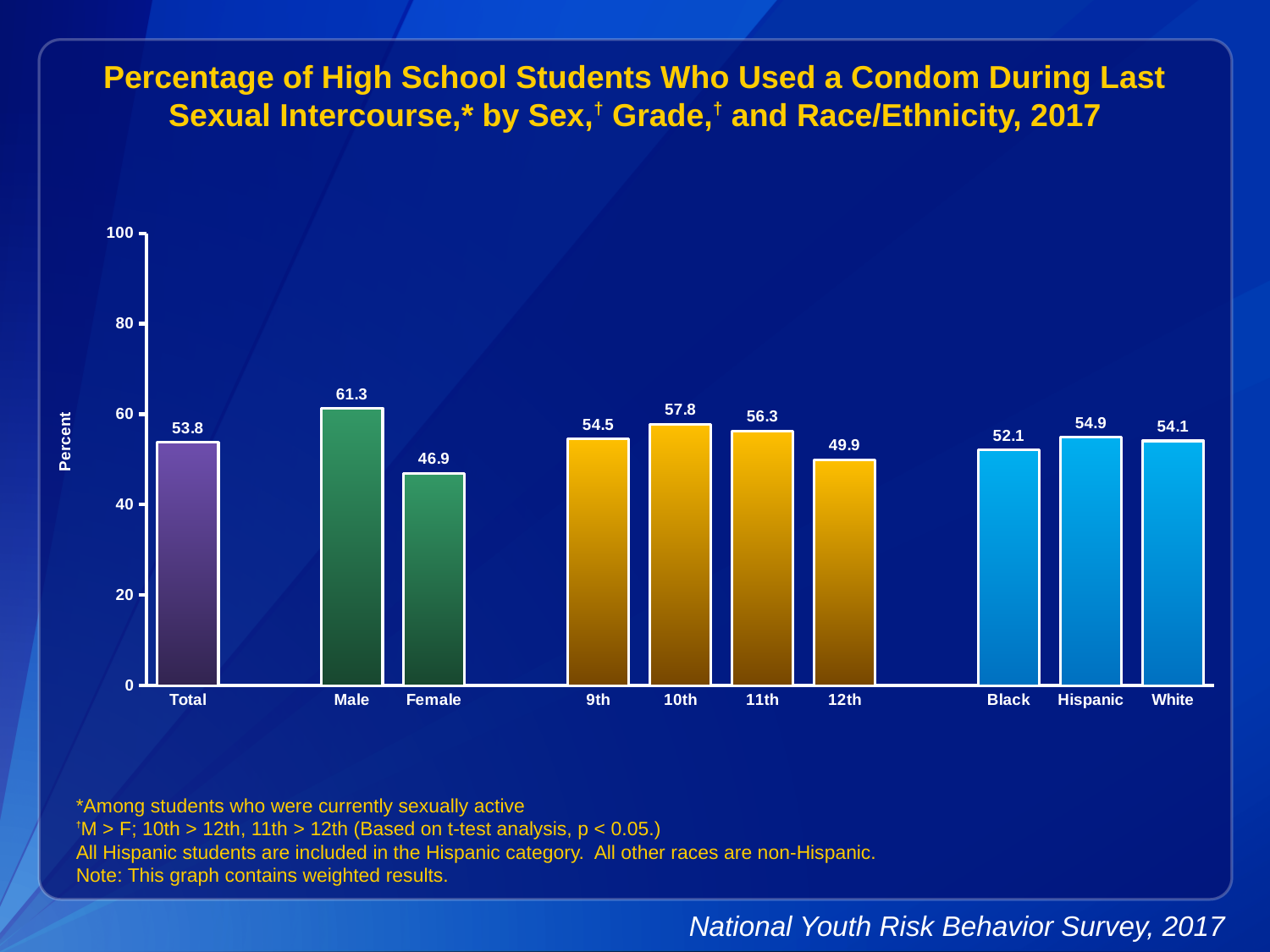
Which category has the highest value? Male What is the value for Total? 53.8 What kind of chart is shown on the slide? bar chart What is the value for 12th grade? 49.9 How many bars are shown in the chart? 10 Which category has the lowest value? Female Is the value for Black students greater or less than 60? less What is the value for Female? 46.9 What is the value for Hispanic students? 54.9 What is the difference between the Male and Female values? 14.4 What is the label on the vertical axis? Percent Which is larger, the value for 10th grade or 11th grade? 10th